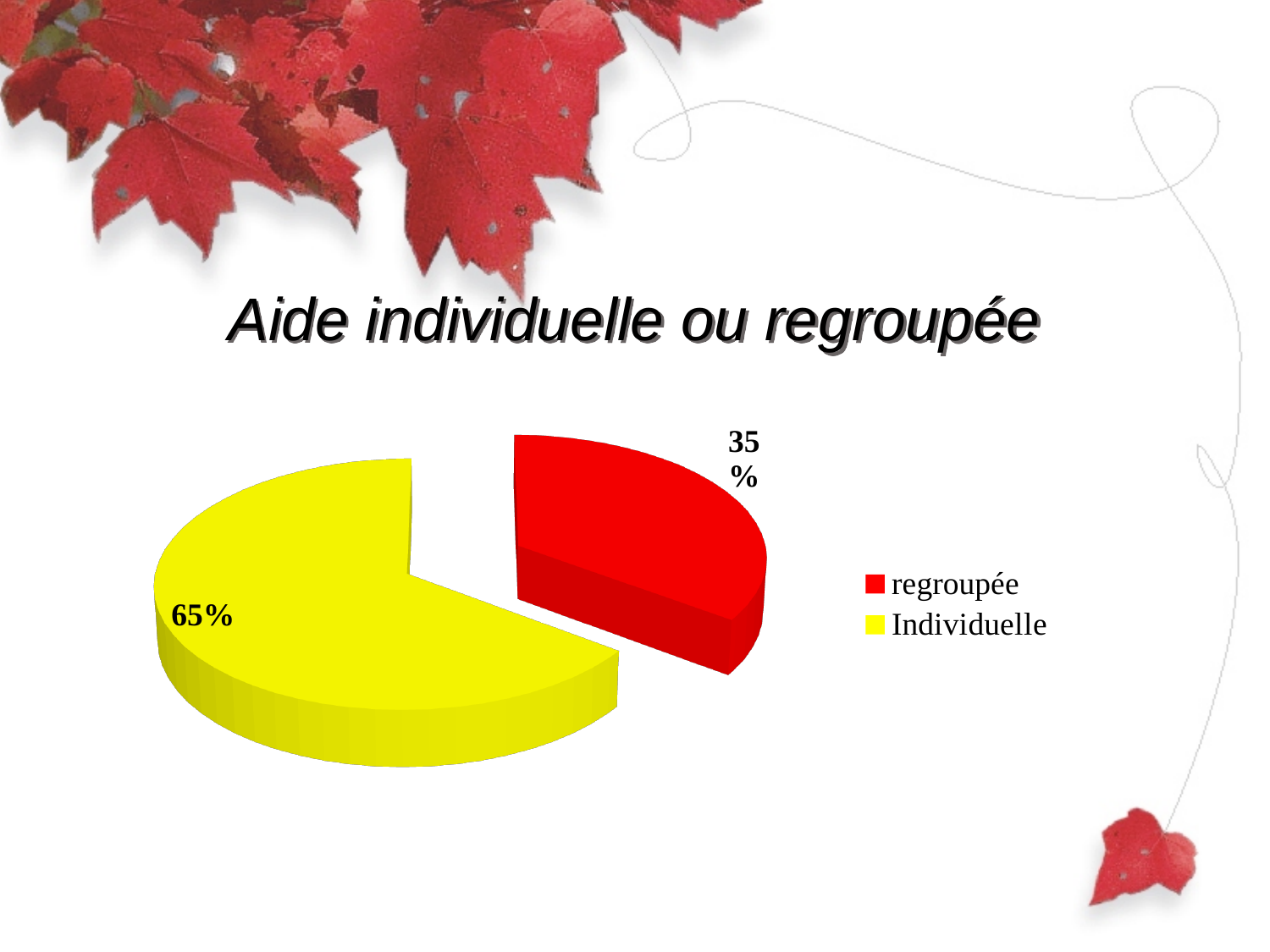
What is the value for regroupée? 35% Which category has the smallest share of the pie? regroupée How many slices does the pie chart have? 2 What colour is the Individuelle slice? yellow What share of the pie does the regroupée slice represent? 35% Which is larger, the share for Individuelle or the share for regroupée? Individuelle What kind of chart is shown on the slide? pie chart Which category has the largest share of the pie? Individuelle What is the value for Individuelle? 65% What is the difference between the Individuelle and regroupée shares? 30% How many entries does the legend list? 2 What is the title of the slide above the chart? Aide individuelle ou regroupée